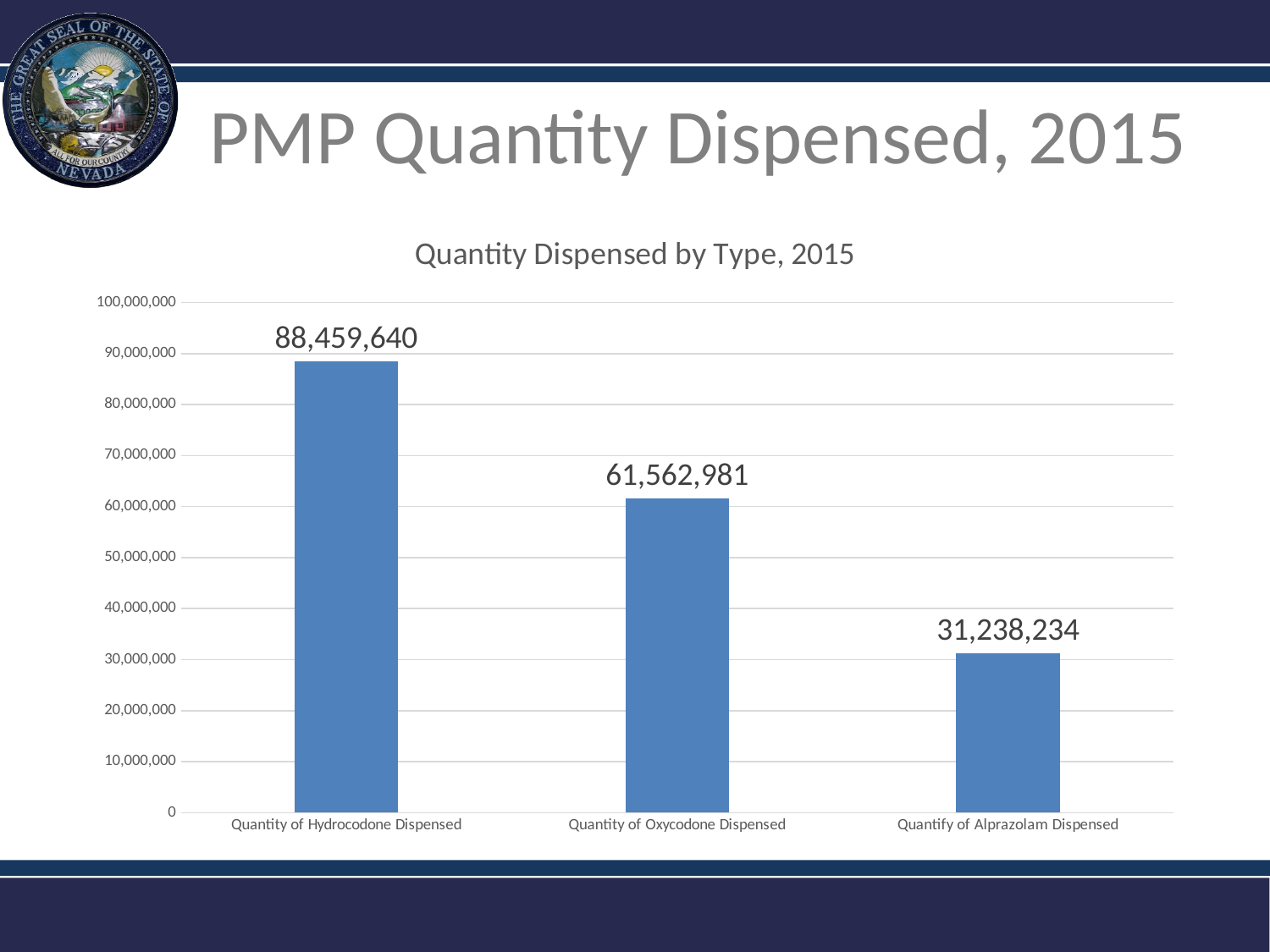
What is the quantity of Oxycodone dispensed? 61,562,981 What is the title of the chart? Quantity Dispensed by Type, 2015 Which drug type has the lowest quantity dispensed? Alprazolam How many drug types are shown in the chart? 3 What is the difference between the quantity of Oxycodone dispensed and the quantity of Alprazolam dispensed? 30,324,747 What is the quantity of Alprazolam dispensed? 31,238,234 Which is larger, the quantity of Oxycodone dispensed or the quantity of Alprazolam dispensed? Oxycodone Which drug type has the highest quantity dispensed? Hydrocodone What is the quantity of Hydrocodone dispensed? 88,459,640 What is the difference between the quantity of Hydrocodone dispensed and the quantity of Oxycodone dispensed? 26,896,659 Is the quantity of Oxycodone dispensed greater or less than 70,000,000? less What kind of chart is shown on the slide? Bar chart